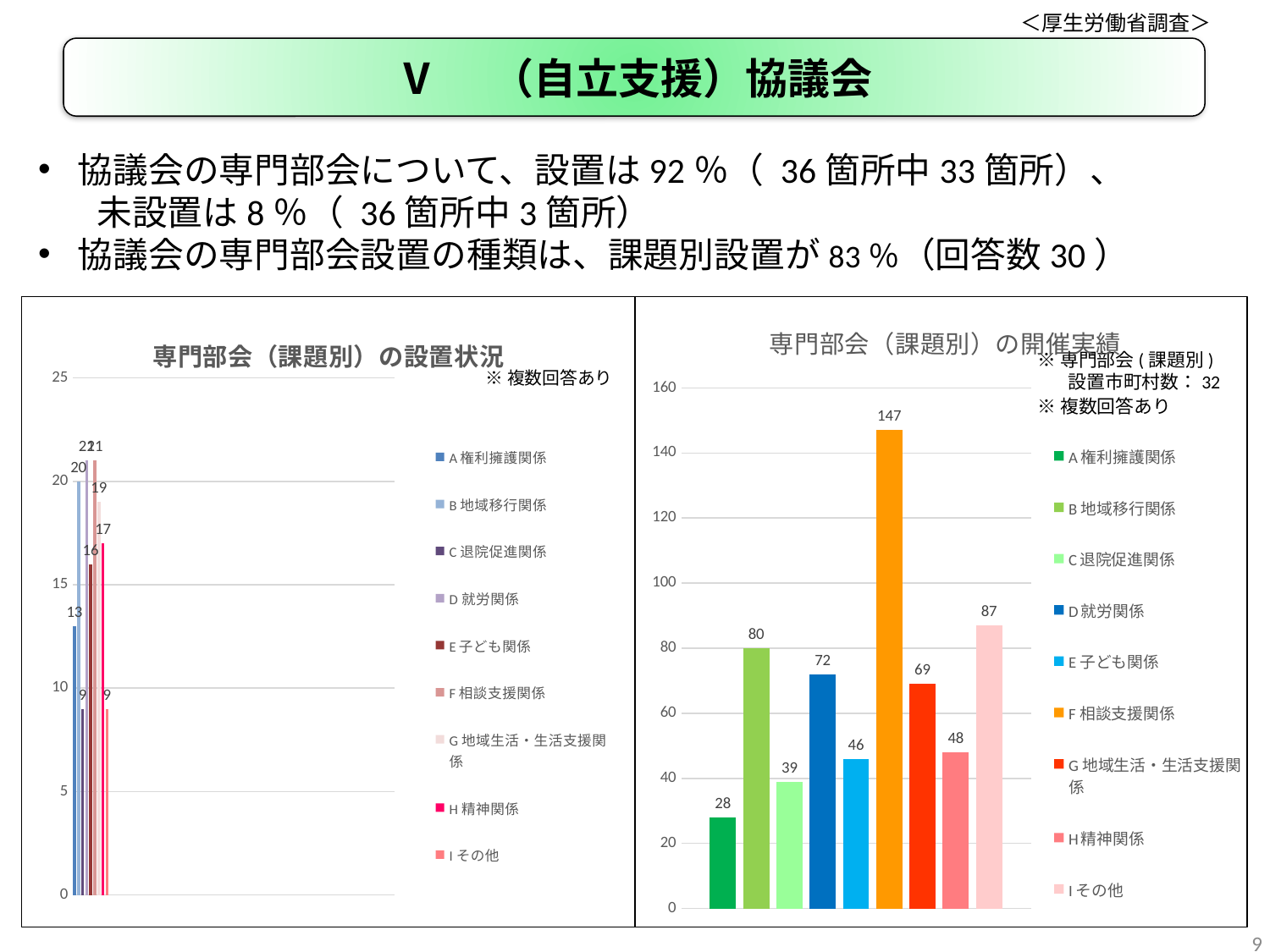
What kind of chart is the right chart (専門部会（課題別）の開催実績)? Bar chart In the right chart (専門部会（課題別）の開催実績), which category has the highest value? F 相談支援関係 In the right chart (専門部会（課題別）の開催実績), how many entries does the legend list? 9 In the right chart (専門部会（課題別）の開催実績), how many bars are plotted? 9 In the right chart (専門部会（課題別）の開催実績), which category has the lowest value? A 権利擁護関係 In the right chart (専門部会（課題別）の開催実績), what is the difference between the values for F 相談支援関係 and I その他? 60 In the right chart (専門部会（課題別）の開催実績), what is the value for C 退院促進関係? 39 What is the title of the left chart? 専門部会（課題別）の設置状況 In the left chart (専門部会（課題別）の設置状況), what is the difference between the values for B 地域移行関係 and A 権利擁護関係? 7 In the left chart (専門部会（課題別）の設置状況), what is the value for A 権利擁護関係? 13 In the right chart (専門部会（課題別）の開催実績), which is larger, the value for B 地域移行関係 or D 就労関係? B 地域移行関係 In the right chart (専門部会（課題別）の開催実績), what is the value for F 相談支援関係? 147